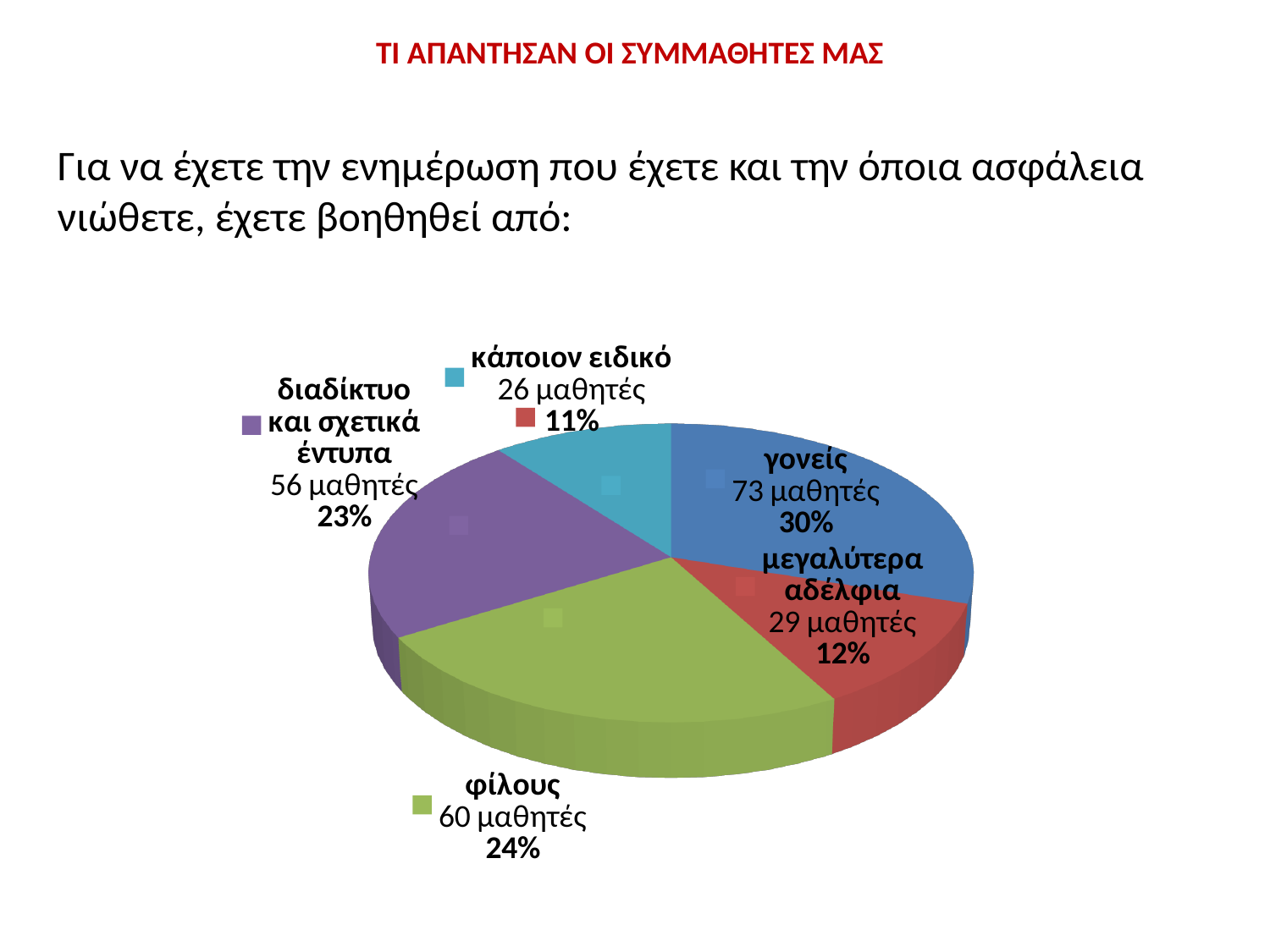
Which category has the largest slice of the pie? γονείς Which category has the smallest slice of the pie? κάποιον ειδικό How many students answered "γονείς"? 73 μαθητές What percentage is shown for "μεγαλύτερα αδέλφια"? 12% How many students answered "διαδίκτυο και σχετικά έντυπα"? 56 μαθητές Which has more students, "φίλους" or "διαδίκτυο και σχετικά έντυπα"? φίλους What percentage is shown for "κάποιον ειδικό"? 11% What percentage of the pie does the "φίλους" slice represent? 24% What kind of chart is shown on the slide? pie chart What colour is the "φίλους" slice? green What is the difference in number of students between "γονείς" and "μεγαλύτερα αδέλφια"? 44 How many slices does the pie chart have? 5